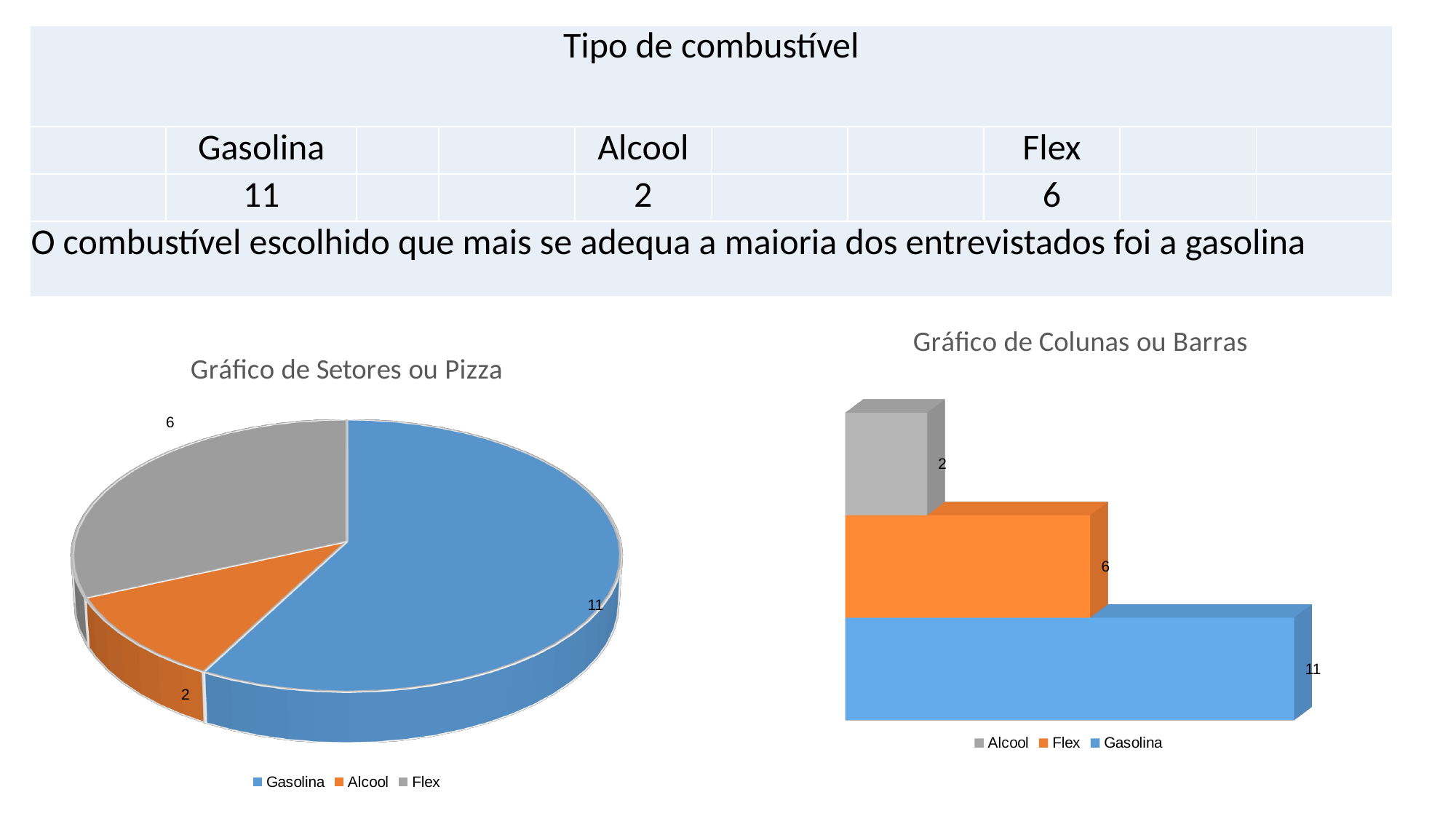
In the chart titled "Gráfico de Setores ou Pizza", what is the value for Flex? 6 In the chart titled "Gráfico de Colunas ou Barras", which category has the shortest bar? Alcool In the chart titled "Gráfico de Colunas ou Barras", what is the value for Alcool? 2 In the chart titled "Gráfico de Setores ou Pizza", what is the value for Gasolina? 11 In the chart titled "Gráfico de Colunas ou Barras", what colour is the bar for Gasolina? Blue In the chart titled "Gráfico de Setores ou Pizza", which category has the largest slice? Gasolina In the chart titled "Gráfico de Colunas ou Barras", what is the difference between the values for Gasolina and Flex? 5 What kind of chart is the chart titled "Gráfico de Setores ou Pizza"? Pie chart What kind of chart is the chart titled "Gráfico de Colunas ou Barras"? Bar chart In the chart titled "Gráfico de Setores ou Pizza", what is the difference between the values for Flex and Alcool? 4 In the chart titled "Gráfico de Colunas ou Barras", which is larger, the value for Flex or the value for Alcool? Flex How many categories are shown in the chart titled "Gráfico de Setores ou Pizza"? 3